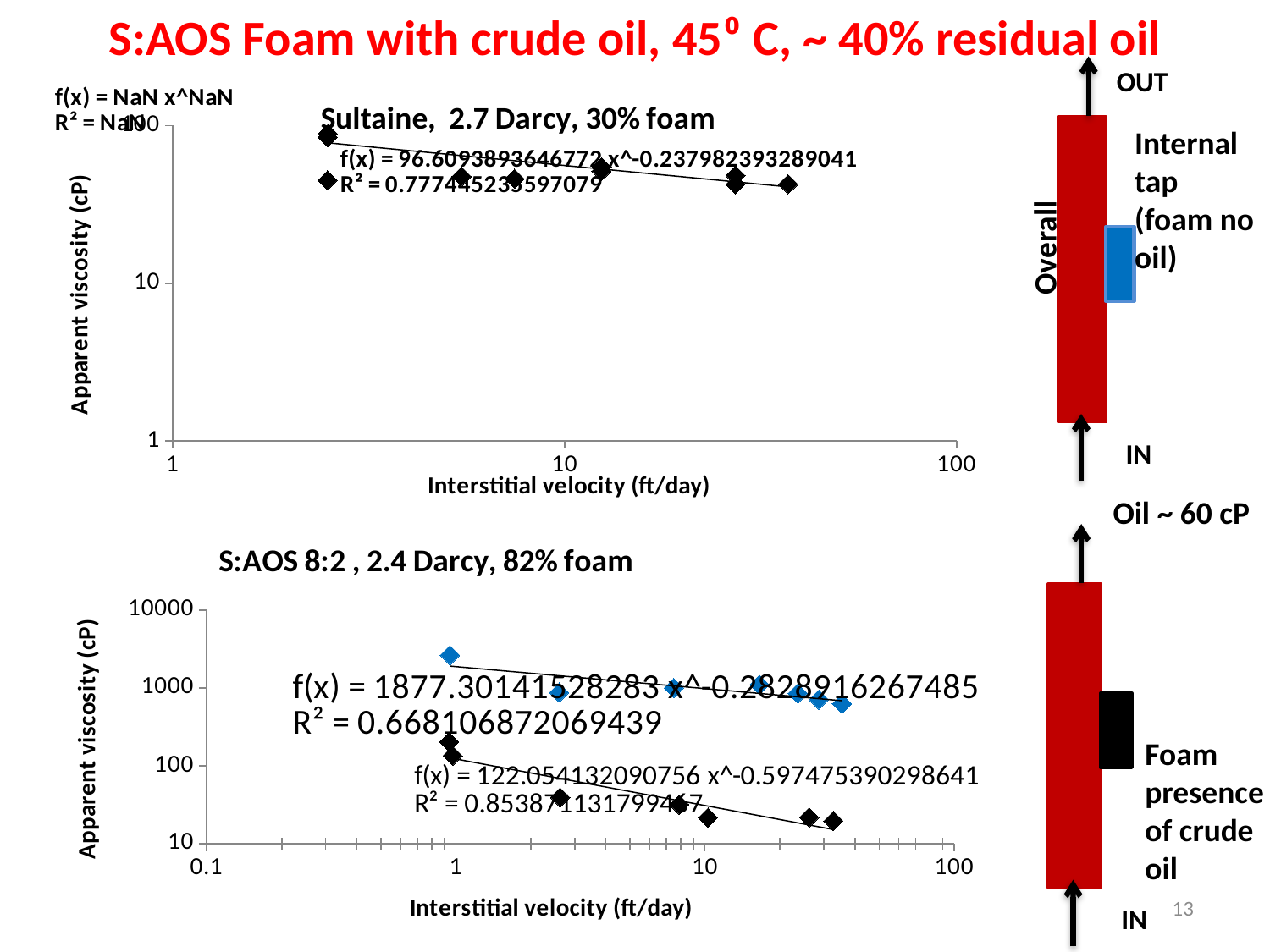
In the top chart (Sultaine, 2.7 Darcy, 30% foam), is the apparent viscosity at the highest plotted velocity (around 38 ft/day) greater or less than 10 cP? greater What R² value is shown for the trendline in the top chart (Sultaine, 2.7 Darcy, 30% foam)? 0.777445233597079 In the bottom chart (S:AOS 8:2, 2.4 Darcy, 82% foam), which series has the higher apparent viscosity values, the blue series or the black series? blue series In the bottom chart (S:AOS 8:2, 2.4 Darcy, 82% foam), does the black series rise or fall as interstitial velocity increases? fall What kind of chart is the top chart titled 'Sultaine, 2.7 Darcy, 30% foam'? scatter chart What is the y-axis title of the bottom chart (S:AOS 8:2, 2.4 Darcy, 82% foam)? Apparent viscosity (cP) In the bottom chart (S:AOS 8:2, 2.4 Darcy, 82% foam), is the blue series value at an interstitial velocity of about 1 ft/day greater or less than 1000 cP? greater In the bottom chart (S:AOS 8:2, 2.4 Darcy, 82% foam), how many data series are plotted? 2 In the top chart (Sultaine, 2.7 Darcy, 30% foam), does apparent viscosity rise or fall as interstitial velocity increases? fall In the bottom chart (S:AOS 8:2, 2.4 Darcy, 82% foam), is the black series value at an interstitial velocity of about 30 ft/day greater or less than 100 cP? less